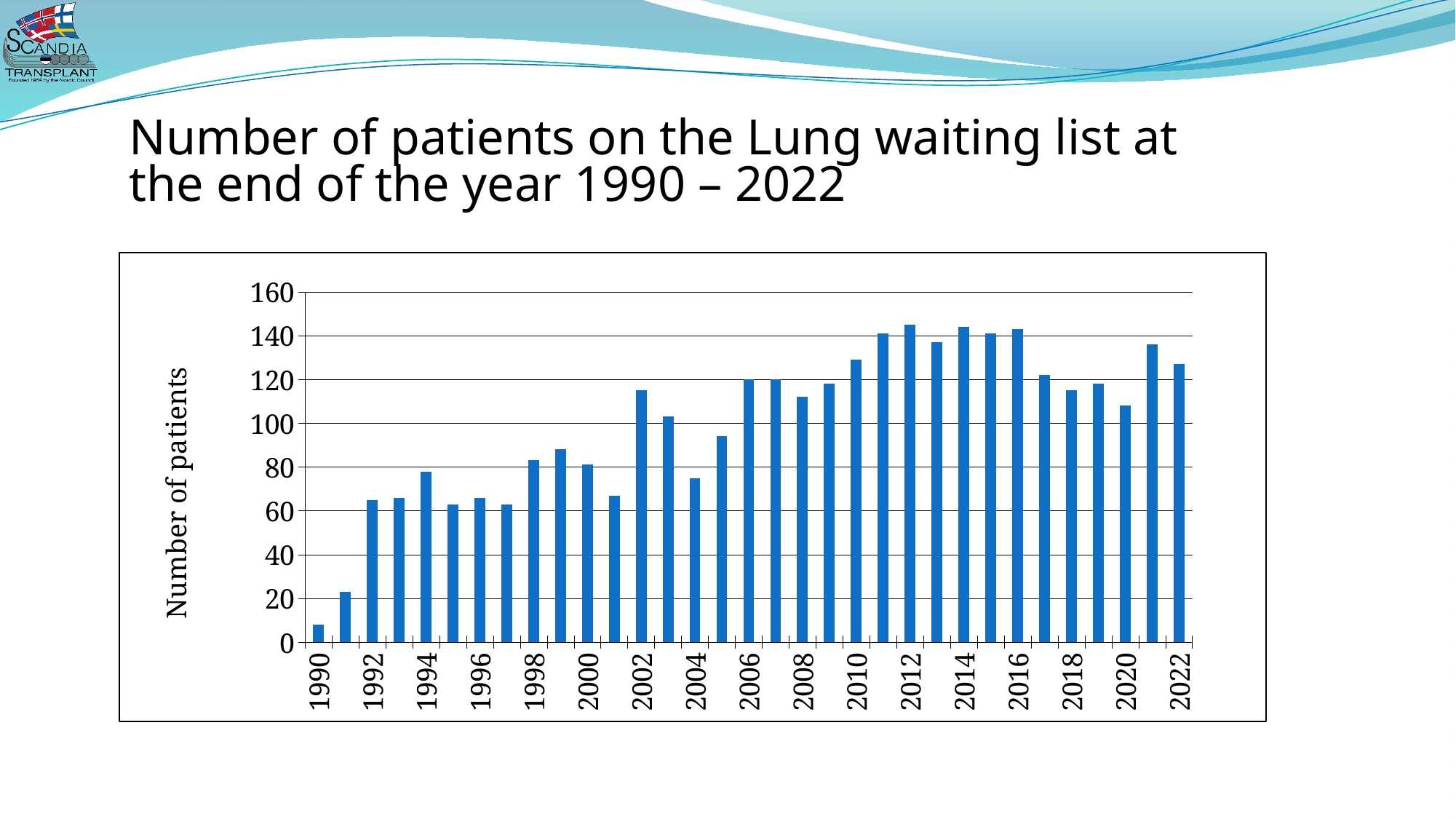
Which year has the lowest number of patients on the lung waiting list? 1990 Is the value for 2018 greater or less than 120? less How many years (bars) are plotted in the chart? 33 Which year has the larger value, 2002 or 2004? 2002 What kind of chart is shown on the slide? bar chart Do the values rise or fall from 2009 to 2012? rise Is the value for 2020 greater or less than 100? greater Is the value for 2004 greater or less than 80? less Which year has the larger value, 2012 or 2020? 2012 What is the label on the vertical axis of the chart? Number of patients